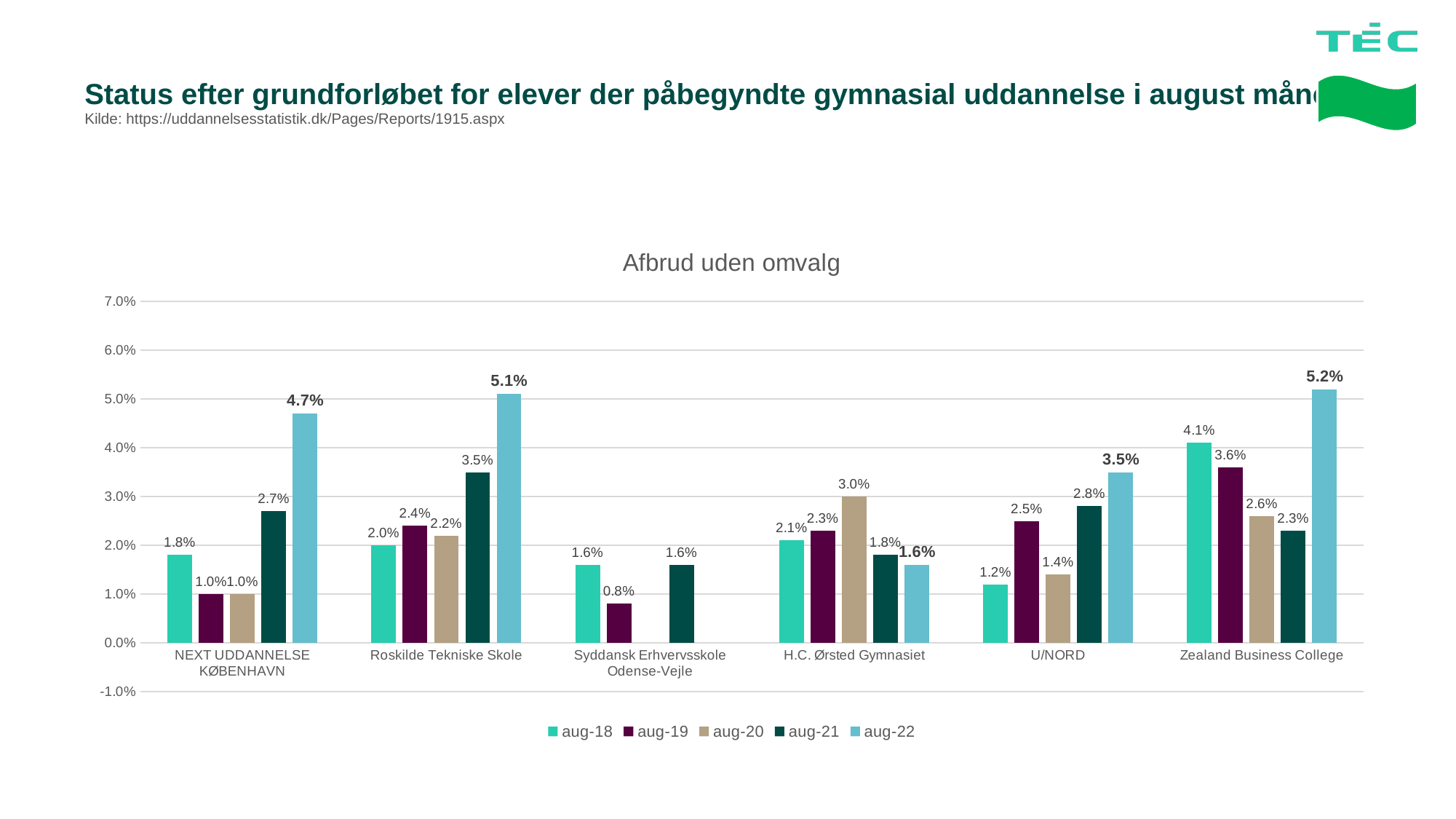
What is the aug-22 value for Zealand Business College? 5.2% How many categories are shown on the x axis? 6 Which category has the highest aug-22 value? Zealand Business College What is the difference between the aug-22 and aug-21 values for Roskilde Tekniske Skole? 1.6% What is the aug-19 value for Syddansk Erhvervsskole Odense-Vejle? 0.8% Which is larger for U/NORD: the aug-19 value or the aug-20 value? aug-19 What is the title of the chart? Afbrud uden omvalg Which category has the lowest aug-18 value? U/NORD What kind of chart is shown? Bar chart What is the aug-21 value for NEXT UDDANNELSE KØBENHAVN? 2.7% How many series does the legend list? 5 What is the aug-20 value for H.C. Ørsted Gymnasiet? 3.0%